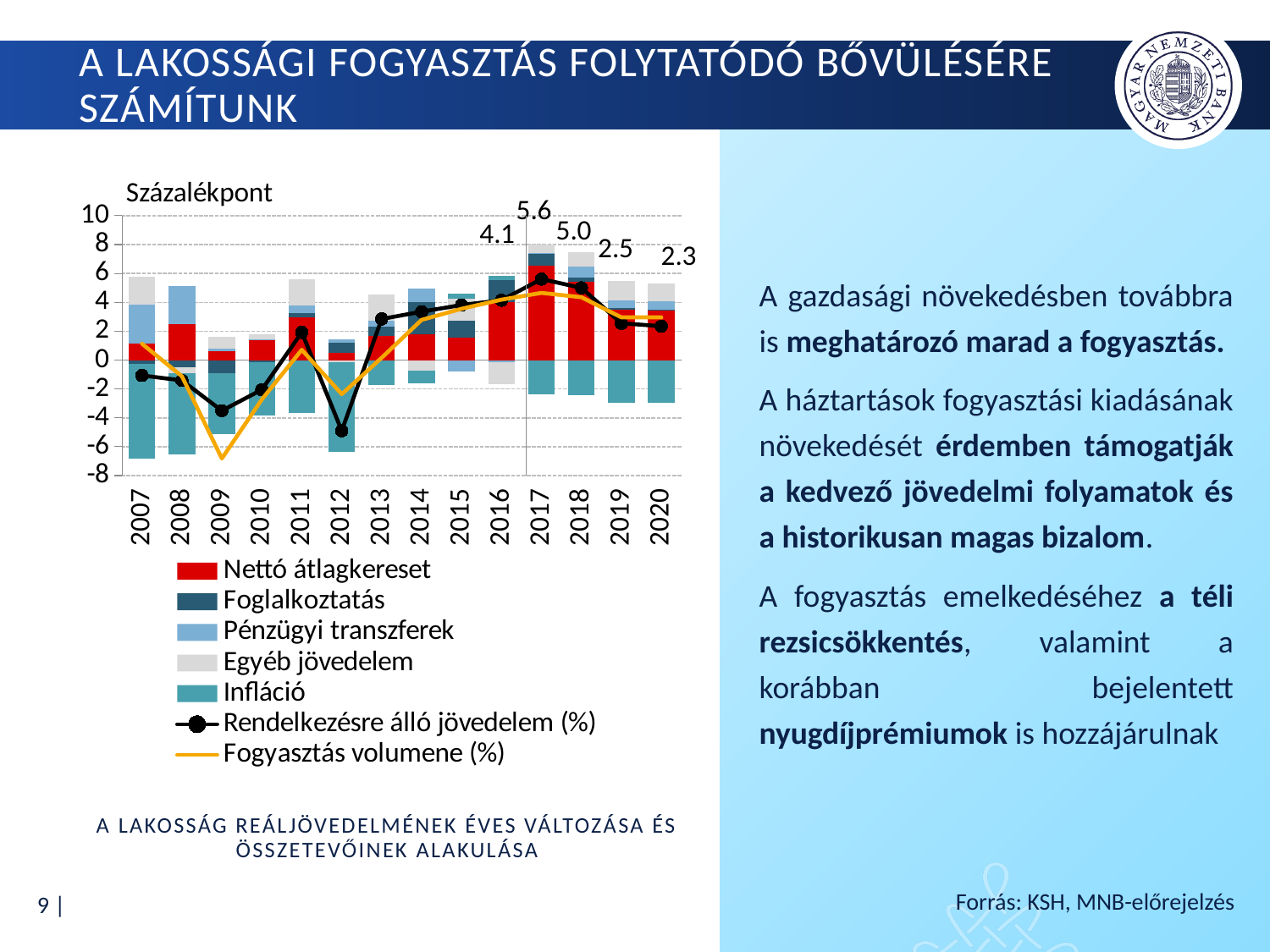
What is the difference between the labelled values for 2017 and 2018? 0.6 Among the years with printed data labels, which year has the highest labelled value? 2017 What kind of chart is shown on the slide? Stacked bar chart with line series What value is labelled above the 2017 bar? 5.6 Which labelled value is larger, 2016 or 2018? 2018 How many years are shown on the x axis? 14 What value is labelled above the 2020 bar? 2.3 What value is labelled above the 2016 bar? 4.1 How many series does the legend list? 7 Among the years with printed data labels, which year has the lowest labelled value? 2020 Do the labelled values rise or fall from 2017 to 2020? fall Is the value of the Rendelkezésre álló jövedelem (%) line for 2012 greater or less than -4? less